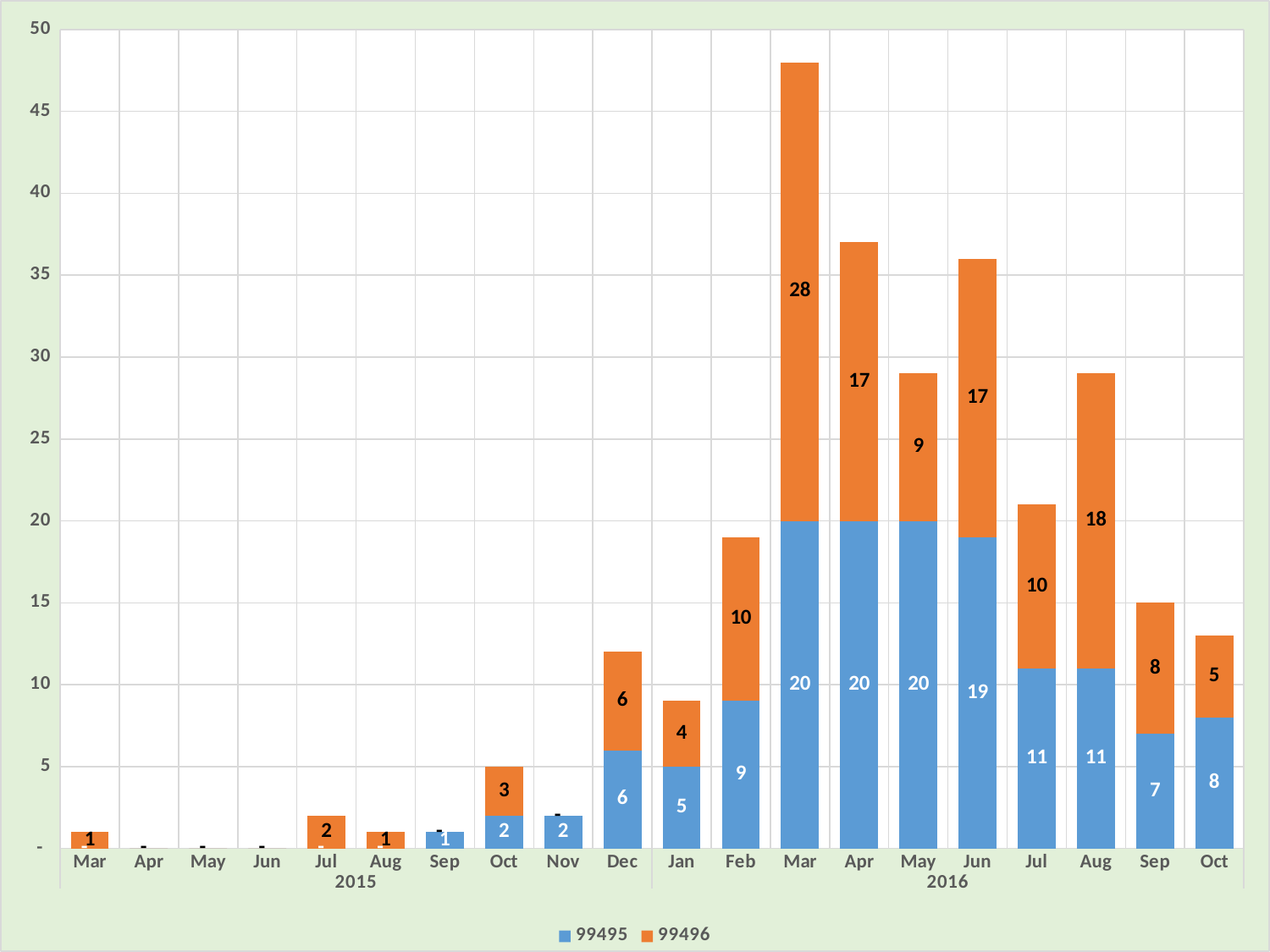
What is the total of the stacked bar for Dec 2015? 12 How many series does the legend list? 2 What type of chart is shown on the slide? stacked bar chart Which month has the highest total stacked bar? Mar 2016 Which is larger for Aug 2016: the 99495 value or the 99496 value? 99496 What is the value of series 99496 for Aug 2016? 18 How many months are shown on the x axis? 20 What is the value of series 99496 for Mar 2016? 28 What is the total of the stacked bar for Mar 2016? 48 What is the difference between the 99496 values for Mar 2016 and Apr 2016? 11 Is the total stacked bar for Apr 2016 greater or less than 35? greater What is the value of series 99495 for Jun 2016? 19